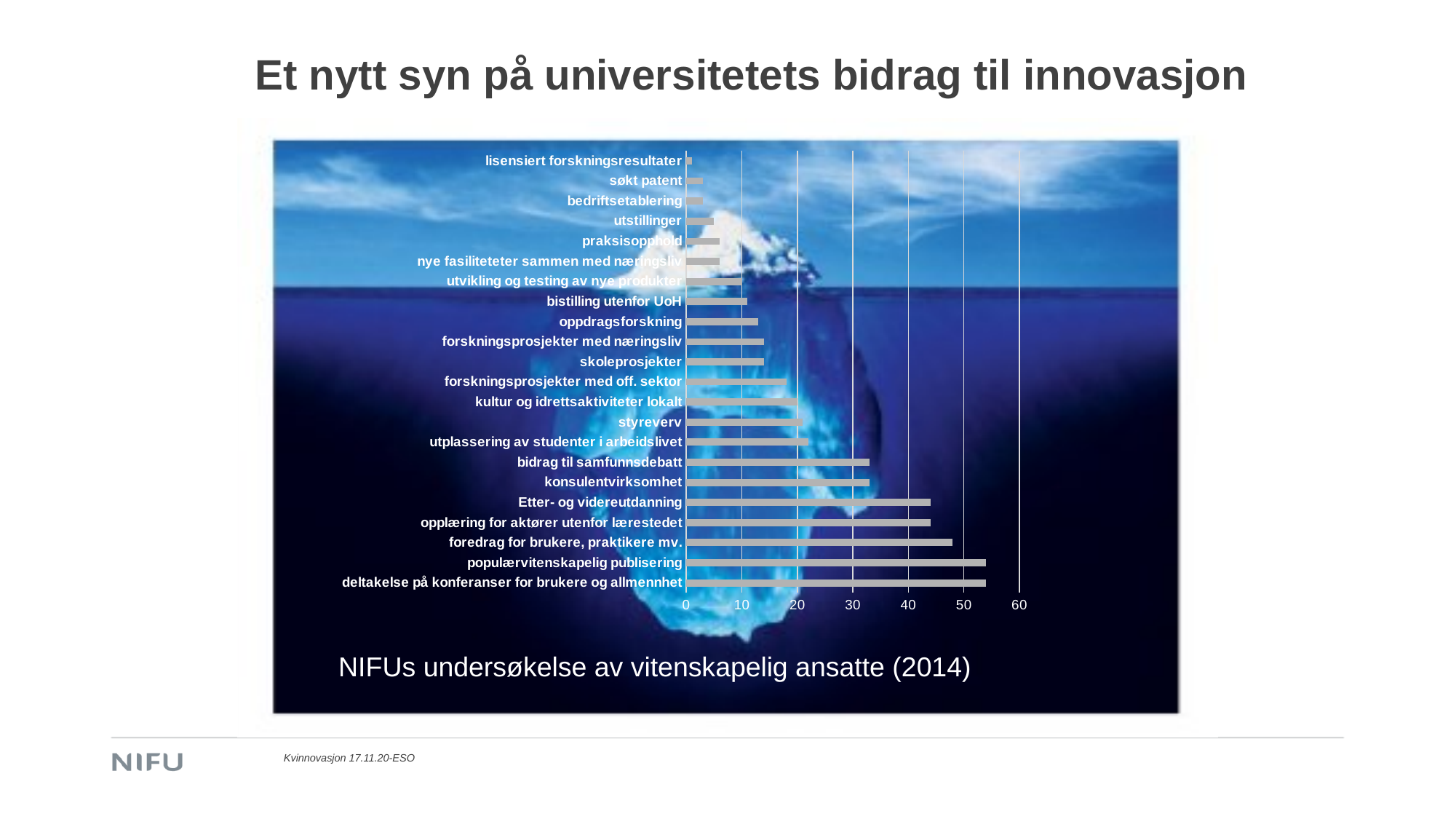
Is the value for 'foredrag for brukere, praktikere mv.' greater or less than 50? less Which category has the lowest value in the chart? lisensiert forskningsresultater Is the value for 'foredrag for brukere, praktikere mv.' greater or less than 40? greater Which has the larger value, 'konsulentvirksomhet' or 'skoleprosjekter'? konsulentvirksomhet Is the value for 'bidrag til samfunnsdebatt' greater or less than 30? greater What is the highest tick value shown on the horizontal axis of the chart? 60 Do the bars generally get longer or shorter going from the top category to the bottom category? longer How many categories are plotted in the bar chart? 22 What kind of chart is shown on the slide? bar chart